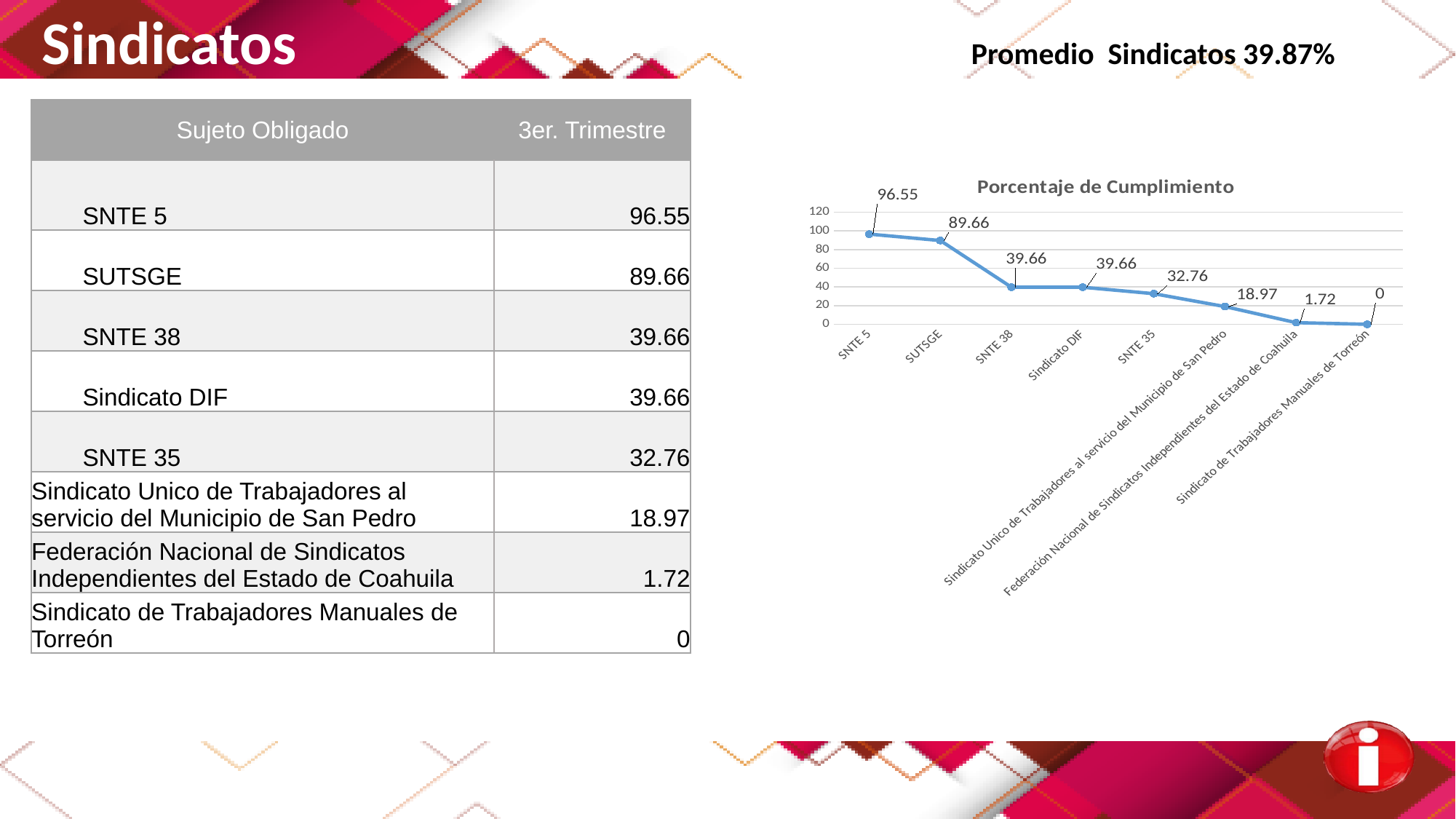
How many categories are plotted on the x axis of the chart? 8 Which category has the lowest value in the chart? Sindicato de Trabajadores Manuales de Torreón Which category has the highest value in the chart? SNTE 5 What is the difference between the values for SNTE 5 and SUTSGE? 6.89 What is the title of the chart? Porcentaje de Cumplimiento What is the value for SNTE 35 in the chart? 32.76 What type of chart is shown on the slide? line chart What is the value for Federación Nacional de Sindicatos Independientes del Estado de Coahuila in the chart? 1.72 What is the value for SNTE 5 in the chart? 96.55 Which is larger, the value for SNTE 35 or the value for Sindicato Unico de Trabajadores al servicio del Municipio de San Pedro? SNTE 35 What is the value for SUTSGE in the chart? 89.66 Do the values rise or fall from left to right along the x axis? fall